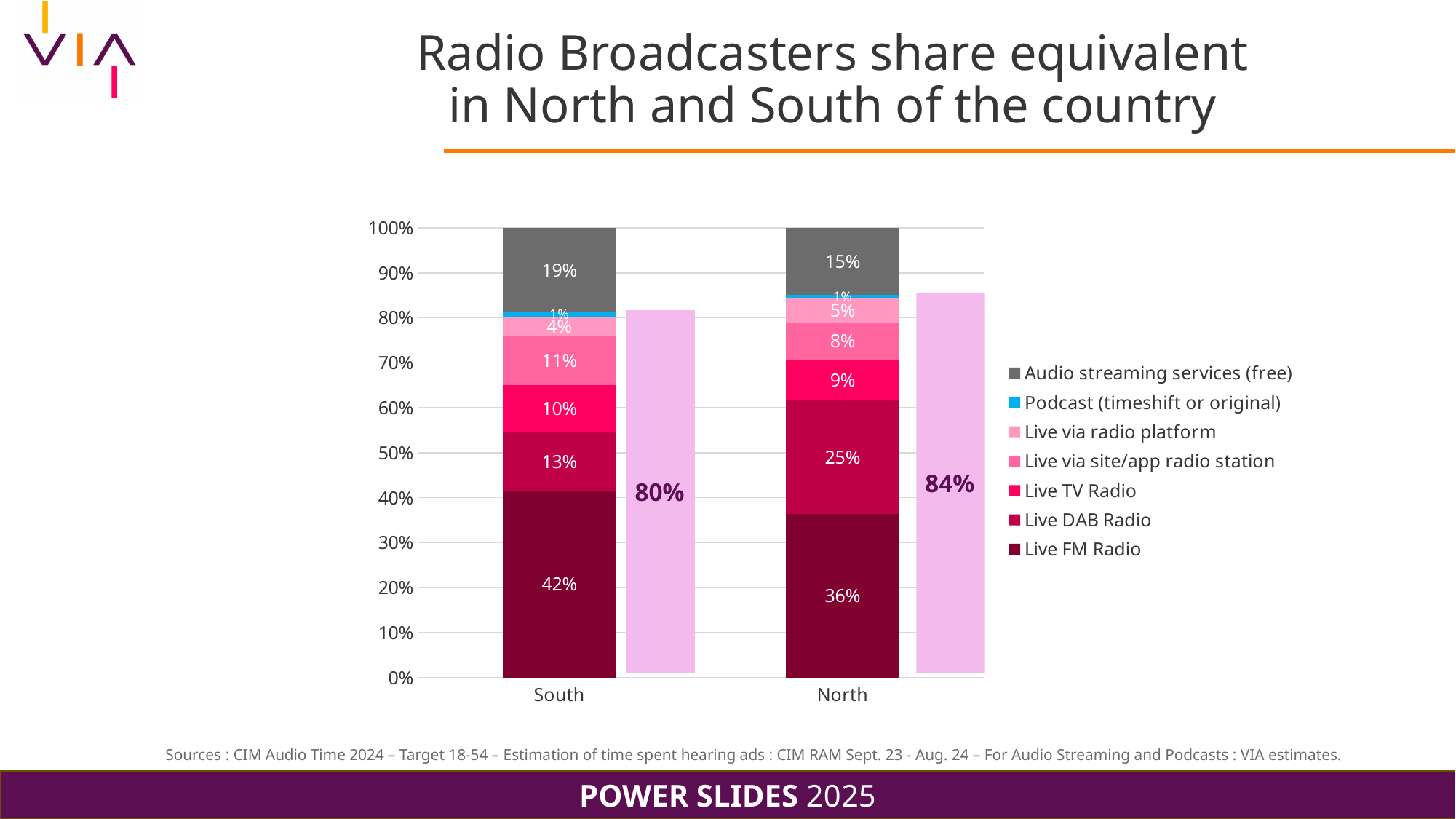
What is the radio broadcasters share shown in the pink bar for North? 84% What is the difference between the radio broadcasters share for North (84%) and South (80%)? 4% Which legend entry is shown in grey? Audio streaming services (free) What kind of chart is shown on the slide? Stacked bar chart What is the value for Live DAB Radio in North? 25% What is the value for Live via site/app radio station in South? 11% How many series does the legend list? 7 What is the value for Live FM Radio in South? 42% What is the difference between the Live DAB Radio values for North and South? 12% Which series has the smallest value in the South stacked bar? Podcast (timeshift or original) Which category has the higher Live FM Radio value, South or North? South What is the value for Audio streaming services (free) in North? 15%